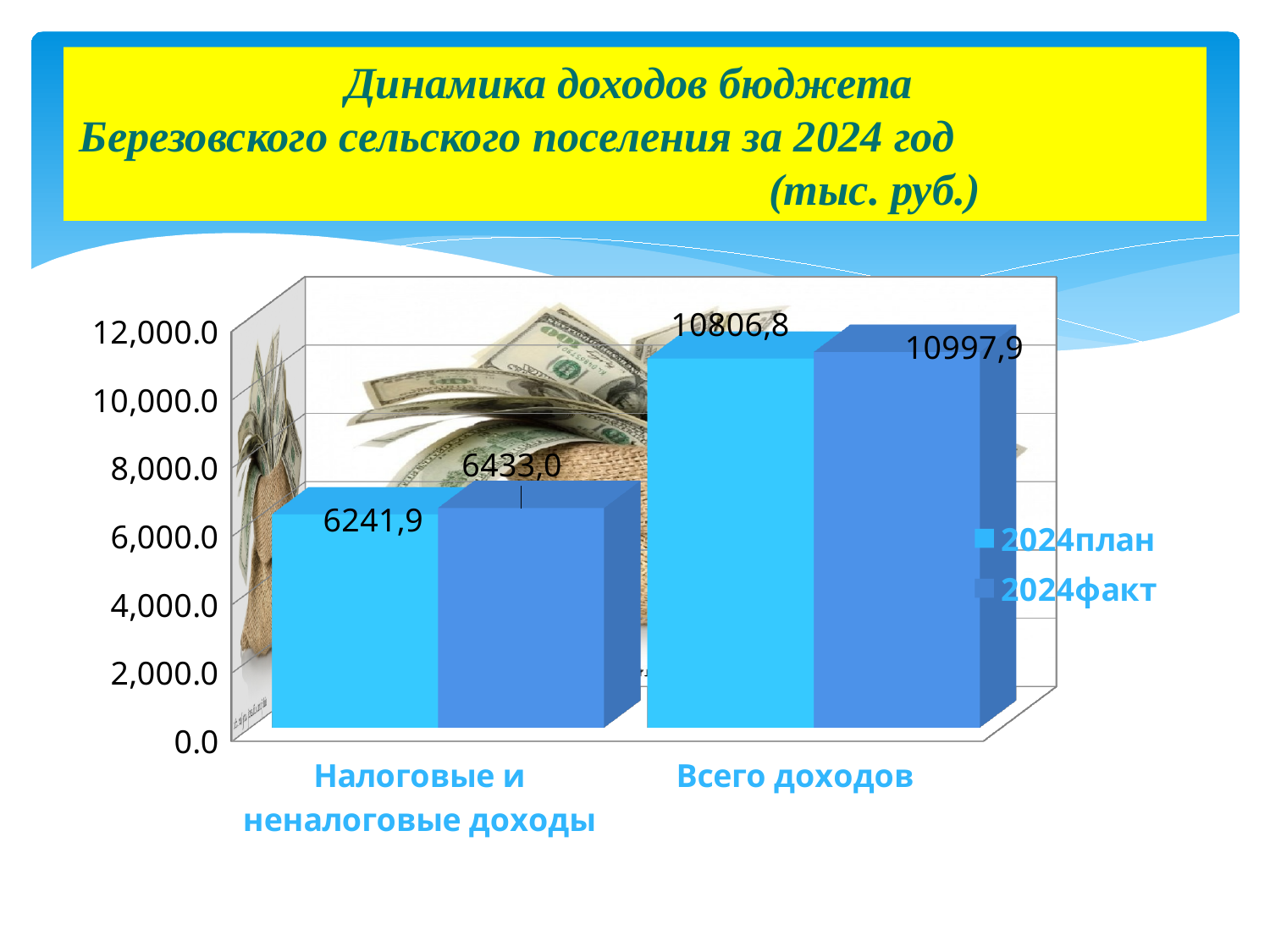
What is the difference between the 2024факт and 2024план values for Налоговые и неналоговые доходы? 191,1 What is the 2024факт value for Налоговые и неналоговые доходы? 6433,0 How many series does the chart legend list? 2 What is the 2024план value for Всего доходов? 10806,8 For Всего доходов, which is larger: the 2024план value or the 2024факт value? 2024факт How many categories are shown on the x axis of the chart? 2 What kind of chart is shown on the slide? Bar chart Which category has the highest 2024факт value? Всего доходов What is the 2024факт value for Всего доходов? 10997,9 What is the 2024план value for Налоговые и неналоговые доходы? 6241,9 What is the difference between the 2024факт and 2024план values for Всего доходов? 191,1 Which category has the lowest 2024план value? Налоговые и неналоговые доходы